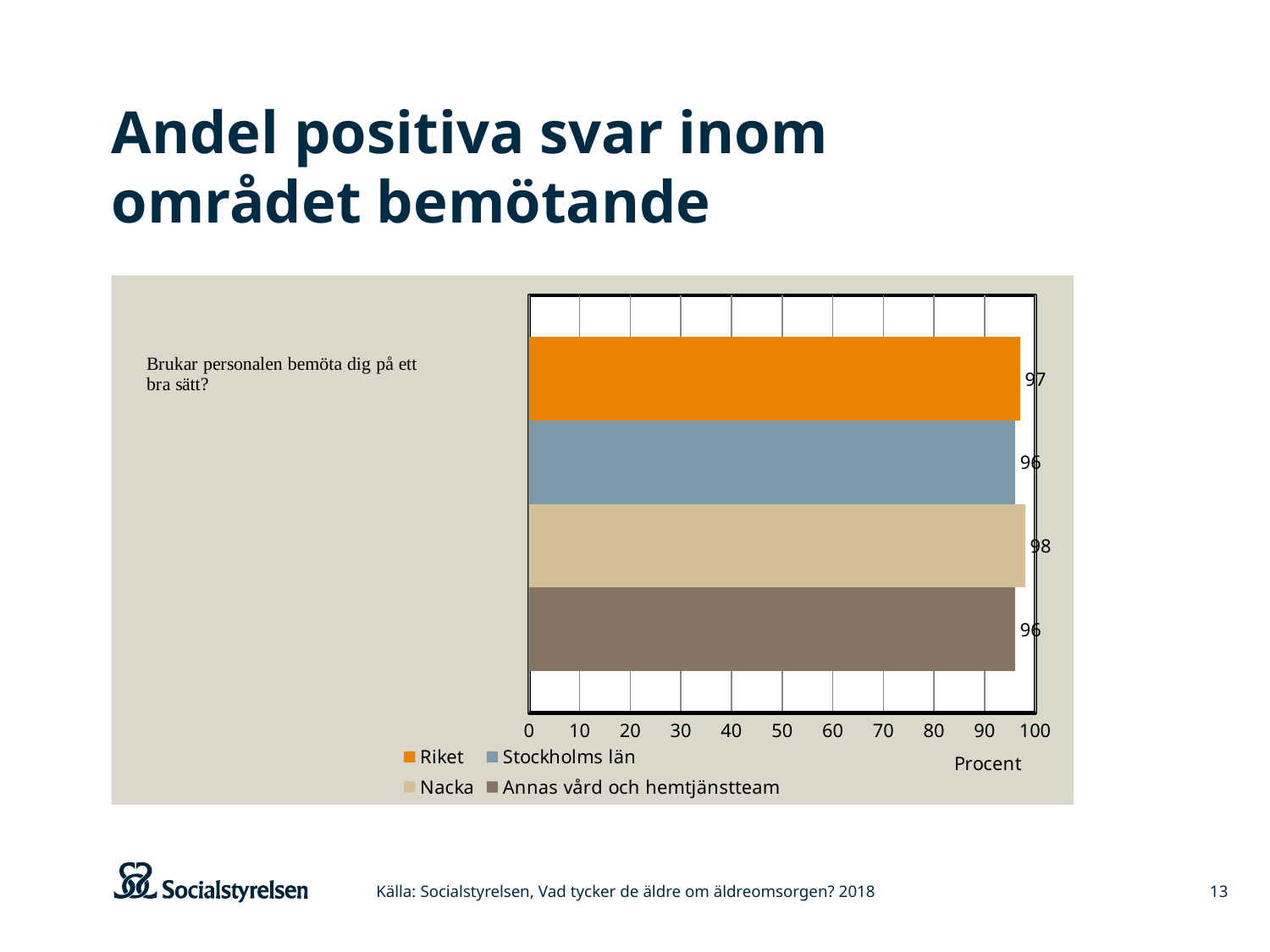
How many series does the legend list? 4 What is the difference between the values for Riket and Annas vård och hemtjänstteam? 1 What is the difference between the values for Nacka and Stockholms län? 2 Which series has the highest value? Nacka What is the value for Stockholms län? 96 Which is larger, the value for Nacka or the value for Riket? Nacka What is the label of the x axis? Procent What is the value for Riket? 97 What is the value for Annas vård och hemtjänstteam? 96 What kind of chart is shown on the slide? Bar chart What is the title of the slide? Andel positiva svar inom området bemötande What is the value for Nacka? 98